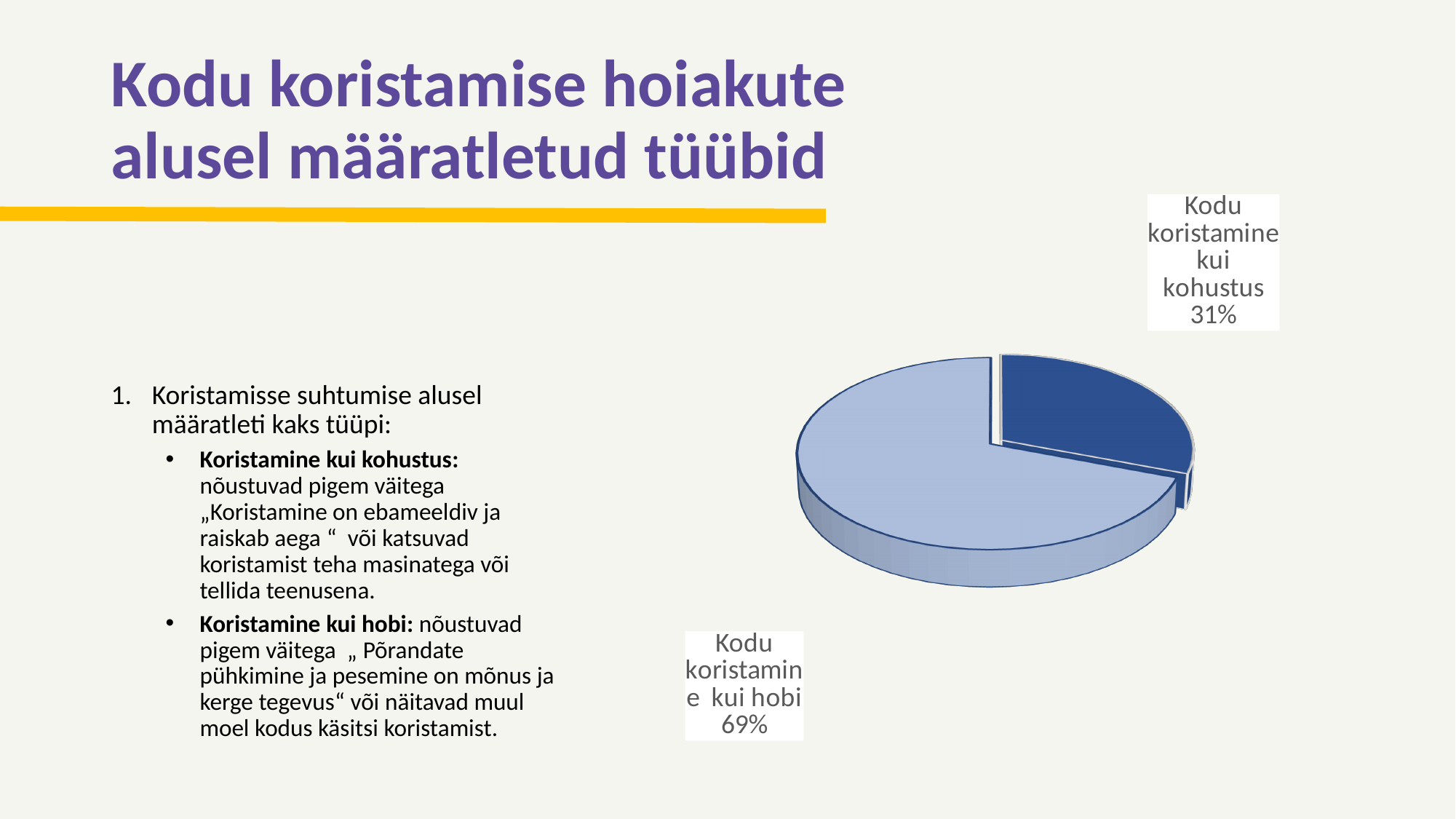
What share of the pie does "Kodu koristamine kui hobi" have? 69% What is the difference in percentage points between the "kui hobi" slice and the "kui kohustus" slice? 38 Which slice of the pie is the smallest? Kodu koristamine kui kohustus How many slices does the pie chart have? 2 Is the share for "Kodu koristamine kui kohustus" greater or less than 50%? less What kind of chart is shown on the slide? pie chart Which slice of the pie is the largest? Kodu koristamine kui hobi Which is larger: the "Kodu koristamine kui kohustus" slice or the "Kodu koristamine kui hobi" slice? Kodu koristamine kui hobi What colour is the "Kodu koristamine kui kohustus" slice? dark blue What share of the pie does "Kodu koristamine kui kohustus" have? 31% What colour is the "Kodu koristamine kui hobi" slice? light blue